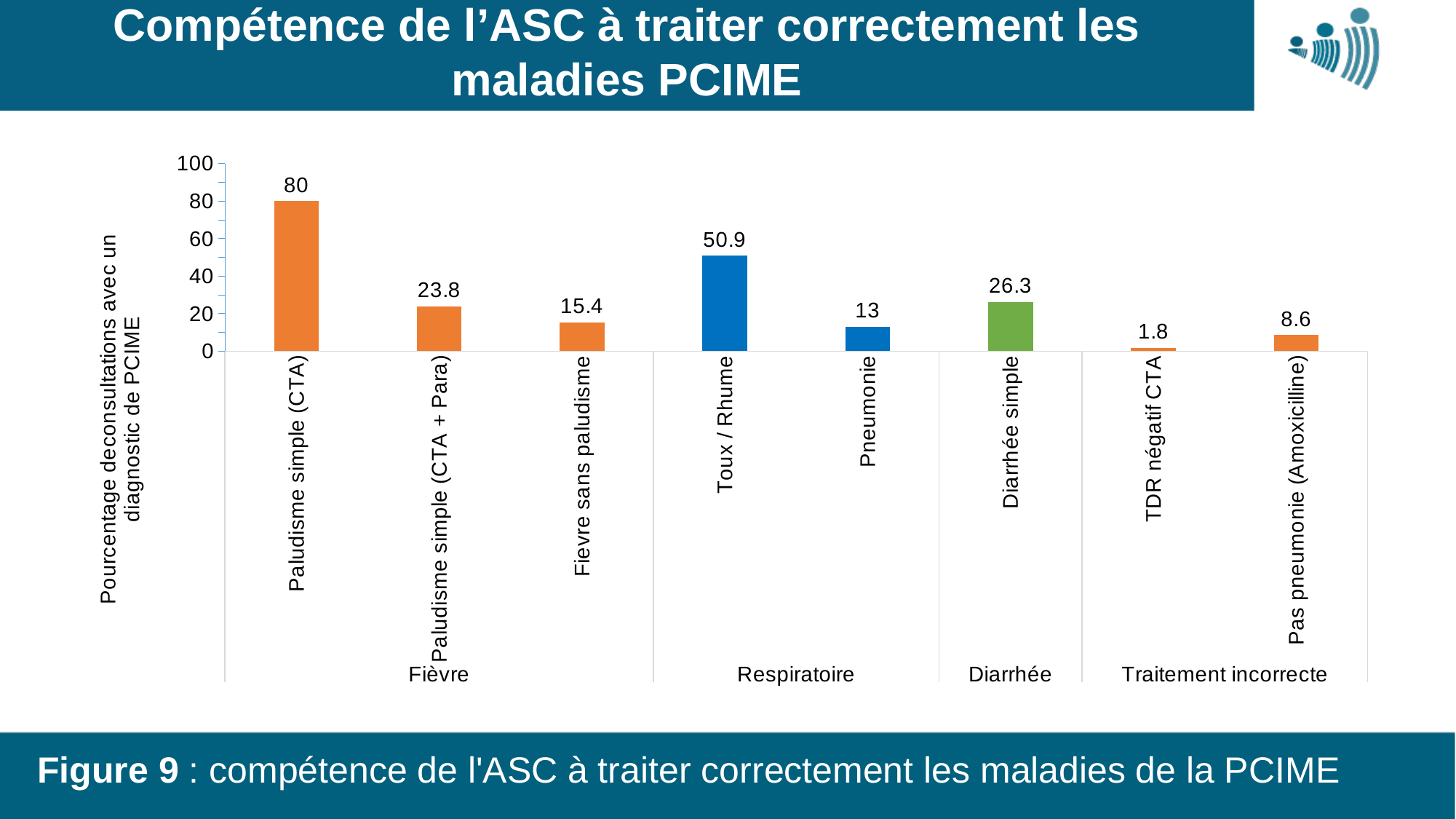
What is the value for Toux / Rhume? 50.9 Which is larger, the value for Fievre sans paludisme or the value for Pneumonie? Fievre sans paludisme Which category has the highest value? Paludisme simple (CTA) How many bars are plotted in the chart? 8 What is the value for Paludisme simple (CTA)? 80 What is the difference between the values for Paludisme simple (CTA) and Paludisme simple (CTA + Para)? 56.2 What is the value for TDR négatif CTA? 1.8 How many category groups are labelled along the bottom of the chart? 4 What is the value for Diarrhée simple? 26.3 Which category has the lowest value? TDR négatif CTA What kind of chart is shown on the slide? Bar chart What is the difference between the values for Toux / Rhume and Pneumonie? 37.9